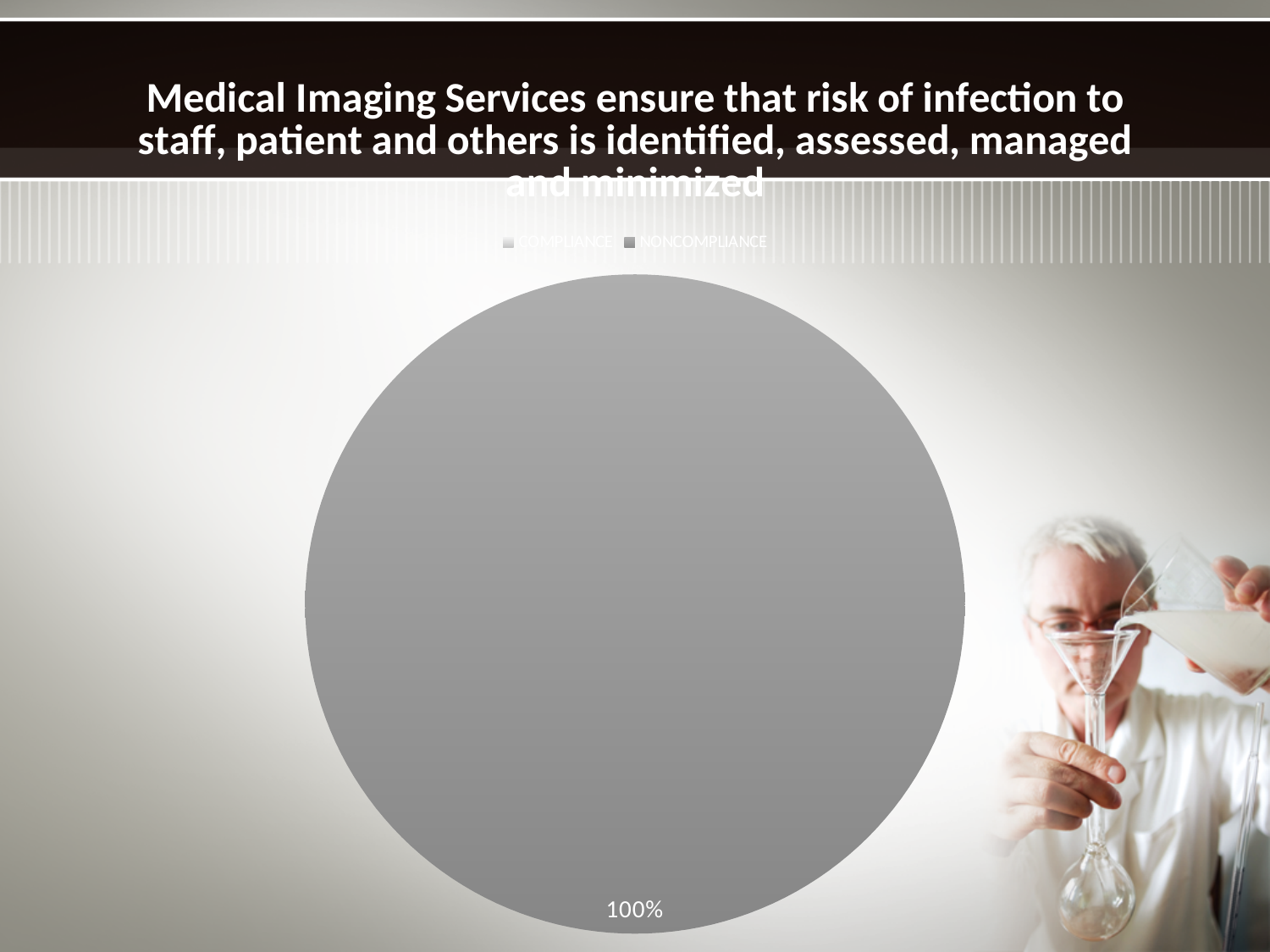
What share of the pie does the single visible slice take up? 100% How many slices are visible in the pie chart? 1 Is the value shown on the pie chart's data label greater or less than 50%? greater What percentage is printed on the data label of the pie chart? 100% What kind of chart is shown on the slide? pie chart How many entries does the chart legend list? 2 What are the two entries listed in the chart legend? COMPLIANCE and NONCOMPLIANCE